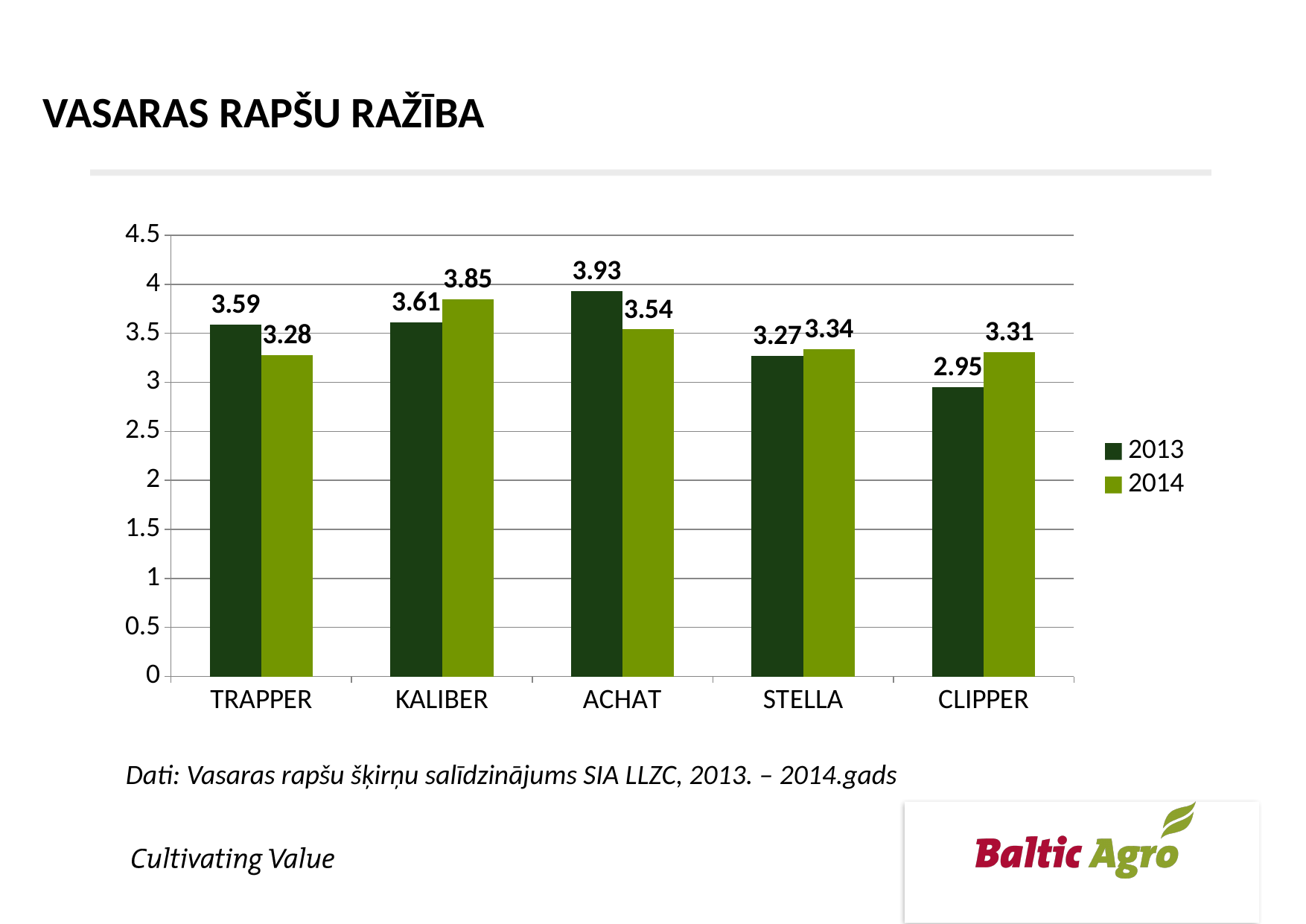
What is the 2014 value for KALIBER? 3.85 How many series does the legend list? 2 What is the 2013 value for ACHAT? 3.93 Which variety has the highest 2014 value? KALIBER What is the title of the slide? VASARAS RAPŠU RAŽĪBA What is the difference between the 2013 and 2014 values for TRAPPER? 0.31 Is the 2013 value for ACHAT greater or less than 3.5? greater Which variety has the lowest 2013 value? CLIPPER How many varieties are shown on the x axis? 5 What is the 2013 value for CLIPPER? 2.95 Which is larger for STELLA, the 2013 value or the 2014 value? 2014 What kind of chart is shown on the slide? bar chart